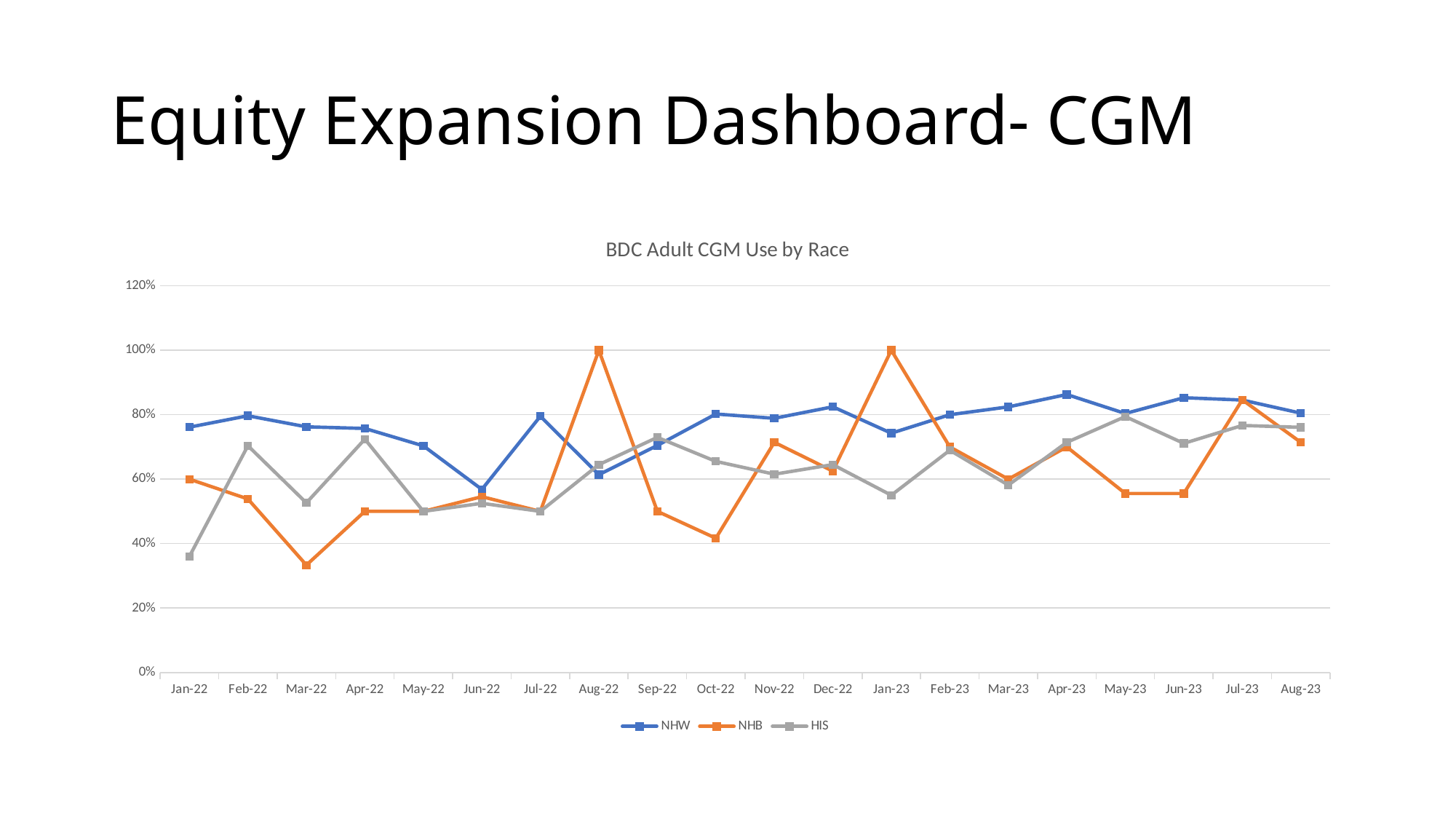
What type of chart is shown on the slide? line chart What is the title of the chart? BDC Adult CGM Use by Race How many series does the legend list? 3 Is the value for NHB in Mar-22 greater or less than 40%? less How many months are plotted along the x axis? 20 In which month is the NHW value lowest? Jun-22 What is the value for NHB in Jan-23? 100% In which month is the HIS value lowest? Jan-22 What is the value for NHB in Aug-22? 100% In Jan-22, which series has the larger value, NHW or HIS? NHW In which month is the NHB value lowest? Mar-22 Is the value for NHW in Apr-23 greater or less than 80%? greater